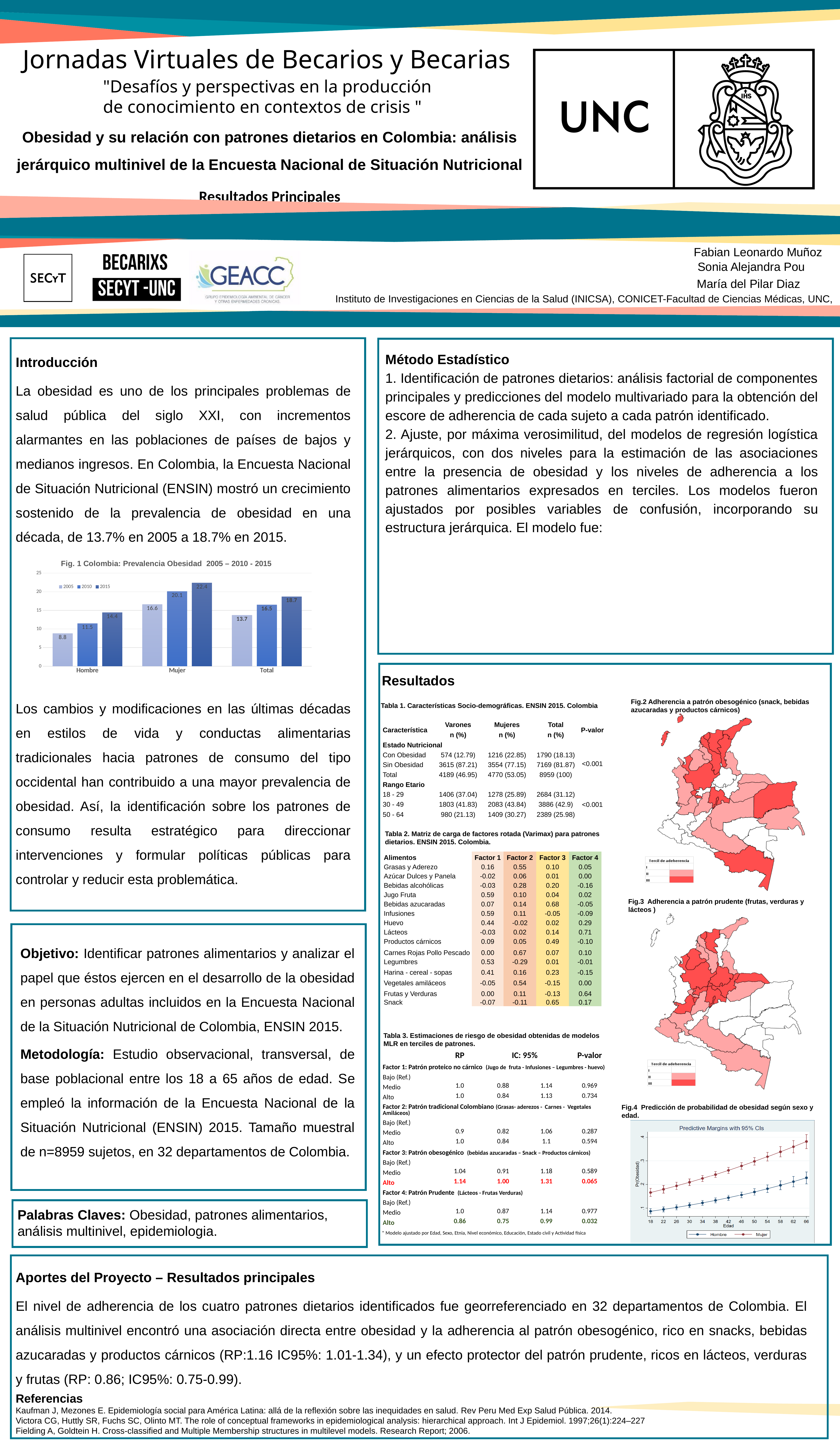
In the Fig. 1 bar chart (Prevalencia Obesidad), what is the value for Total in 2010? 16.5 In the Fig. 1 bar chart (Prevalencia Obesidad), do the values for Total rise or fall from 2005 to 2015? rise In the Fig. 1 bar chart (Prevalencia Obesidad), how many categories are shown on the x axis? 3 In the Fig. 1 bar chart (Prevalencia Obesidad), how many series does the legend list? 3 In the Fig. 1 bar chart (Prevalencia Obesidad), what is the difference between the Mujer and Hombre values in 2015? 8.0 In the Fig. 1 bar chart (Prevalencia Obesidad), which category has the lowest value in 2005? Hombre In the Fig. 1 bar chart (Prevalencia Obesidad), what is the value for Mujer in 2015? 22.4 What kind of chart is Fig. 1 (Prevalencia Obesidad)? bar chart In the Fig. 1 bar chart (Prevalencia Obesidad), which is larger: Total in 2015 or Mujer in 2005? Total in 2015 In the Fig. 1 bar chart (Prevalencia Obesidad), which category has the highest value in 2015? Mujer In the Fig. 4 chart (Predictive Margins with 95% CIs), how many series does the legend list? 2 In the Fig. 1 bar chart (Prevalencia Obesidad), what is the value for Hombre in 2005? 8.8